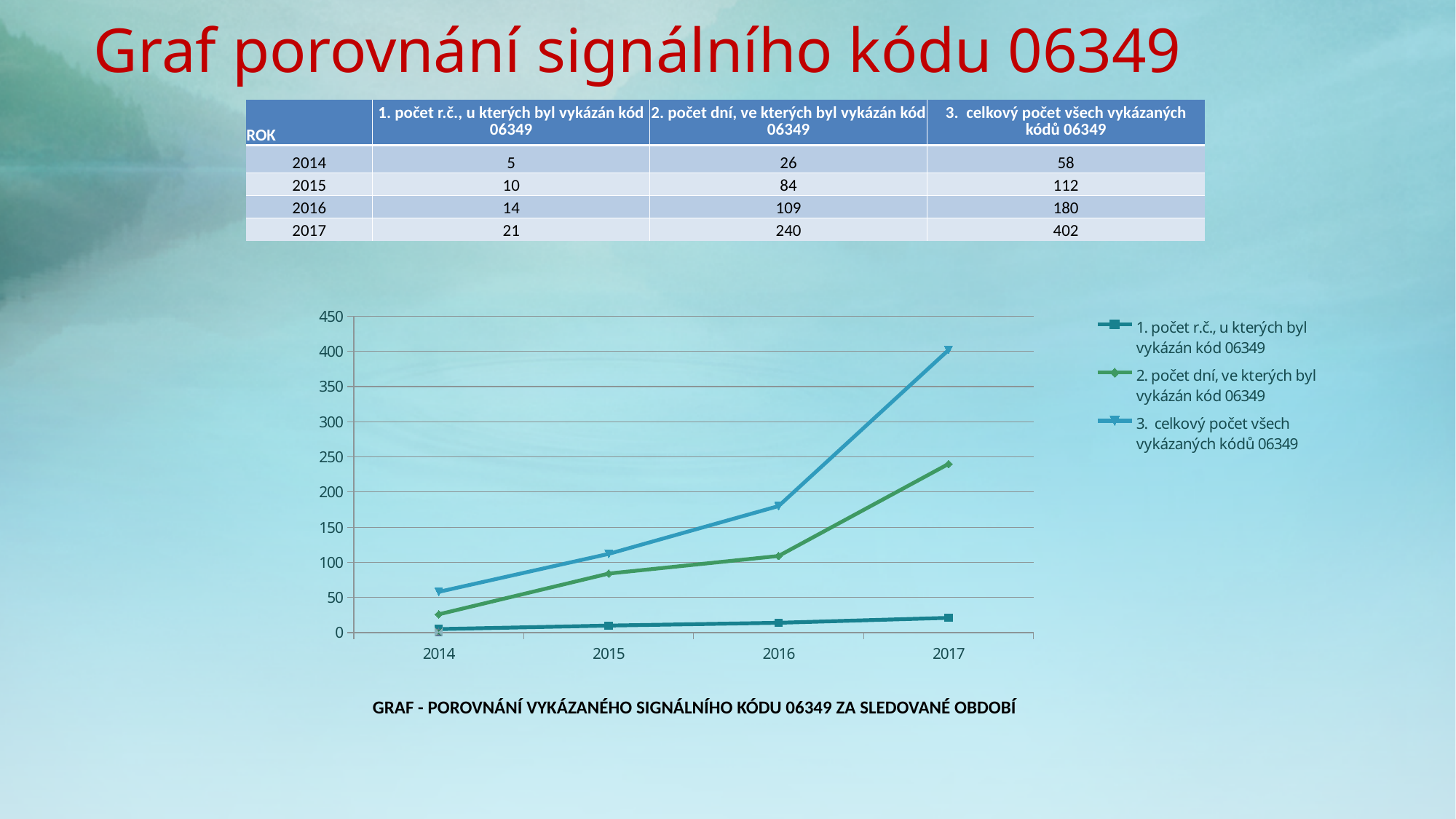
What is the difference between the 2017 and 2016 values of series '3. celkový počet všech vykázaných kódů 06349'? 222 Is the 2017 value of series '2. počet dní, ve kterých byl vykázán kód 06349' greater or less than 200? greater How many series does the chart legend list? 3 Which is larger in 2016: the value of series '2. počet dní, ve kterých byl vykázán kód 06349' or series '3. celkový počet všech vykázaných kódů 06349'? 3. celkový počet všech vykázaných kódů 06349 Do the values of series '3. celkový počet všech vykázaných kódů 06349' rise or fall from 2014 to 2017? rise How many years are plotted along the x axis of the chart? 4 What is the value of series '2. počet dní, ve kterých byl vykázán kód 06349' in 2015? 84 In which year is the series '2. počet dní, ve kterých byl vykázán kód 06349' lowest? 2014 What kind of chart is shown on the slide? line chart In which year is the series '3. celkový počet všech vykázaných kódů 06349' highest? 2017 What is the value of series '3. celkový počet všech vykázaných kódů 06349' in 2017? 402 What is the value of series '1. počet r.č., u kterých byl vykázán kód 06349' in 2016? 14